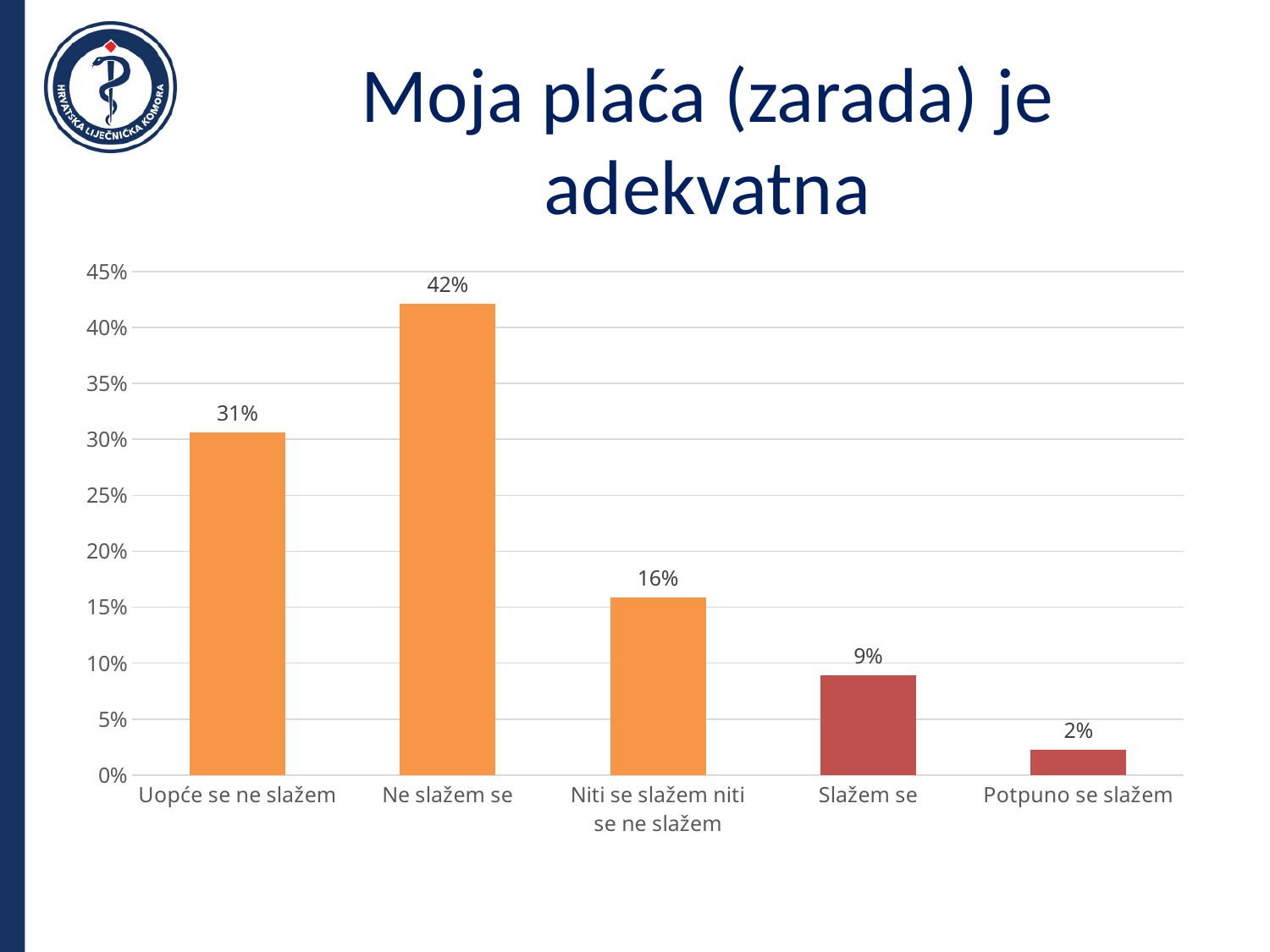
What is the value for "Slažem se"? 9% What is the value for "Potpuno se slažem"? 2% What is the title of the slide? Moja plaća (zarada) je adekvatna Which is larger, the value for "Niti se slažem niti se ne slažem" or the value for "Slažem se"? Niti se slažem niti se ne slažem Which category has the highest value? Ne slažem se How many categories are shown on the x axis? 5 What is the value for "Uopće se ne slažem"? 31% What is the value for "Ne slažem se"? 42% Is the value for "Niti se slažem niti se ne slažem" greater or less than 20%? less What kind of chart is shown on the slide? bar chart What is the difference between the values for "Ne slažem se" and "Uopće se ne slažem"? 11% Which category has the lowest value? Potpuno se slažem